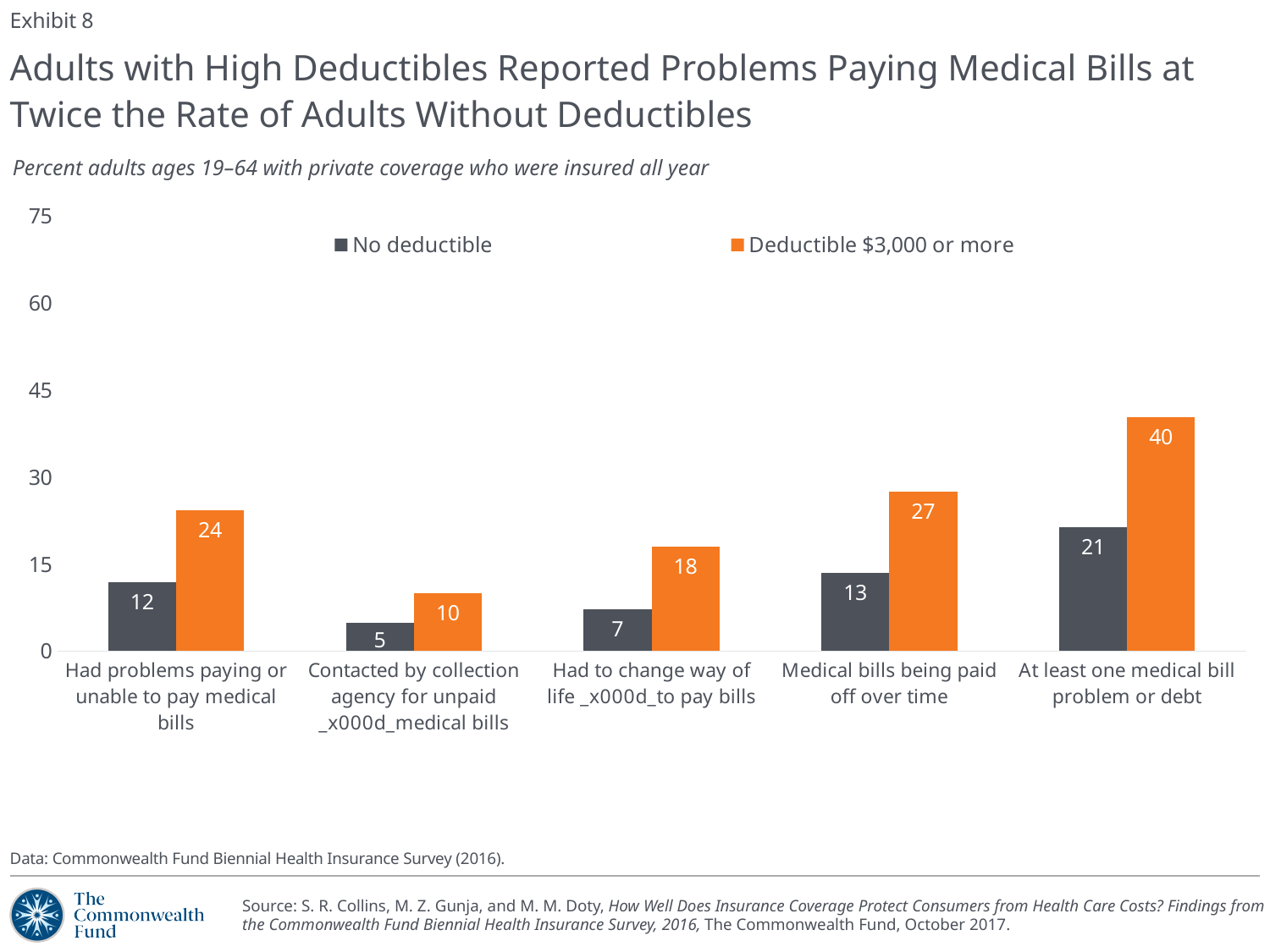
Which category has the highest value for "Deductible $3,000 or more"? At least one medical bill problem or debt What is the difference between the "Deductible $3,000 or more" and "No deductible" values in the "Had to change way of life to pay bills" category? 11 How many series does the legend list? 2 Which category has the lowest value for "No deductible"? Contacted by collection agency for unpaid medical bills What colour are the bars for the "Deductible $3,000 or more" series? Orange How many categories are shown on the x axis? 5 Which is larger in the "Medical bills being paid off over time" category: the "No deductible" value or the "Deductible $3,000 or more" value? Deductible $3,000 or more What is the value for "No deductible" in the "Medical bills being paid off over time" category? 13 What kind of chart is shown on the slide? Bar chart What is the value for "Deductible $3,000 or more" in the "At least one medical bill problem or debt" category? 40 What is the value for "No deductible" in the "Had problems paying or unable to pay medical bills" category? 12 Is the "Deductible $3,000 or more" value for "At least one medical bill problem or debt" greater or less than 30? greater